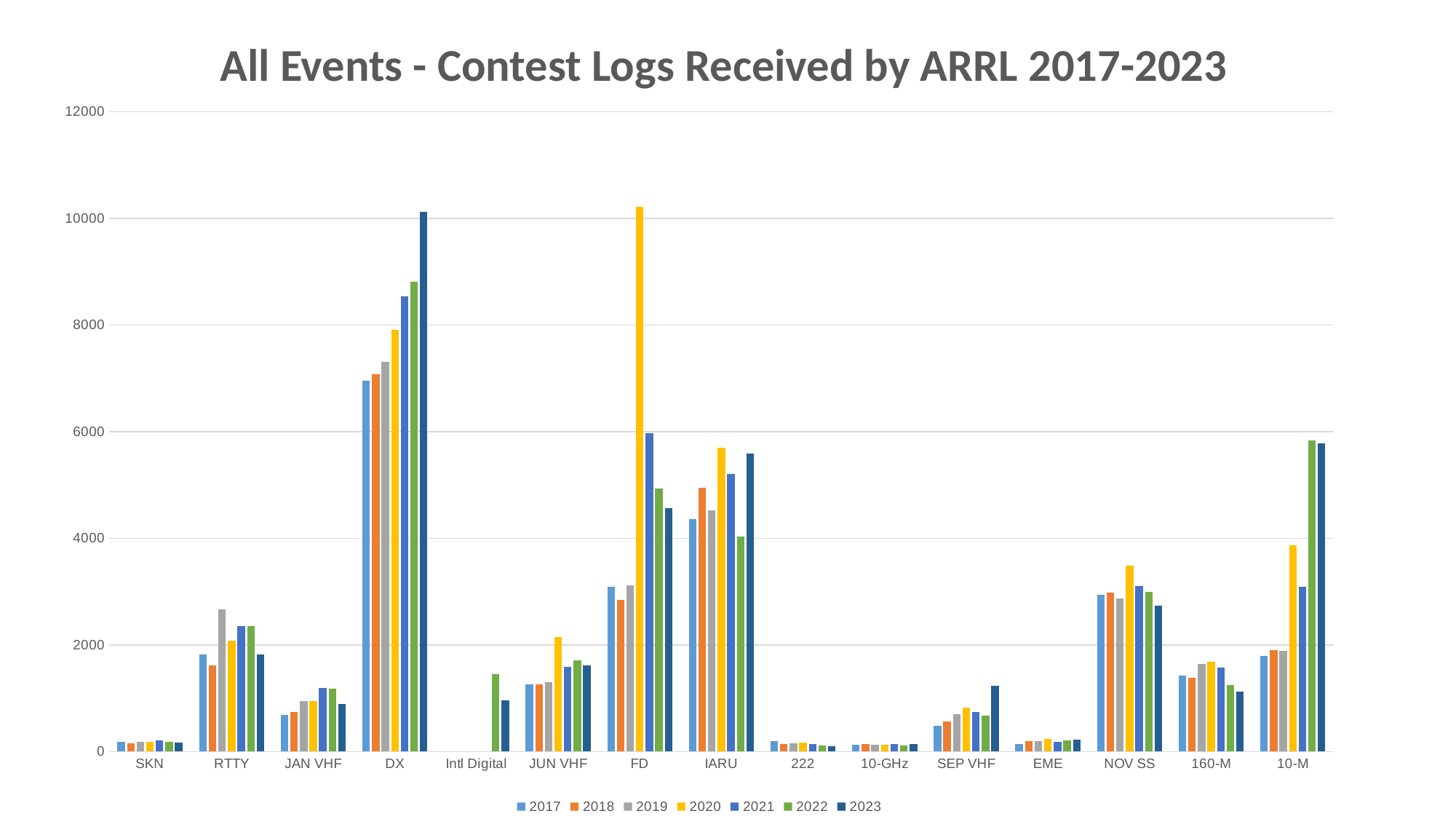
Which year has the highest bar for the DX event? 2023 Which year has the highest bar for the RTTY event? 2019 What is the title of the chart? All Events - Contest Logs Received by ARRL 2017-2023 How many series (years) does the legend list? 7 Is the value for IARU in 2020 greater or less than 6000? less Is the value for NOV SS in 2020 greater or less than 3000? greater Is the value for DX in 2022 greater or less than 8000? greater Which year has the highest bar for the FD event? 2020 Do the DX bars rise or fall from 2017 to 2023? rise What kind of chart is shown on the slide? bar chart Which is larger, the 2018 value for IARU or the 2018 value for FD? IARU How many event categories are shown along the x axis? 15